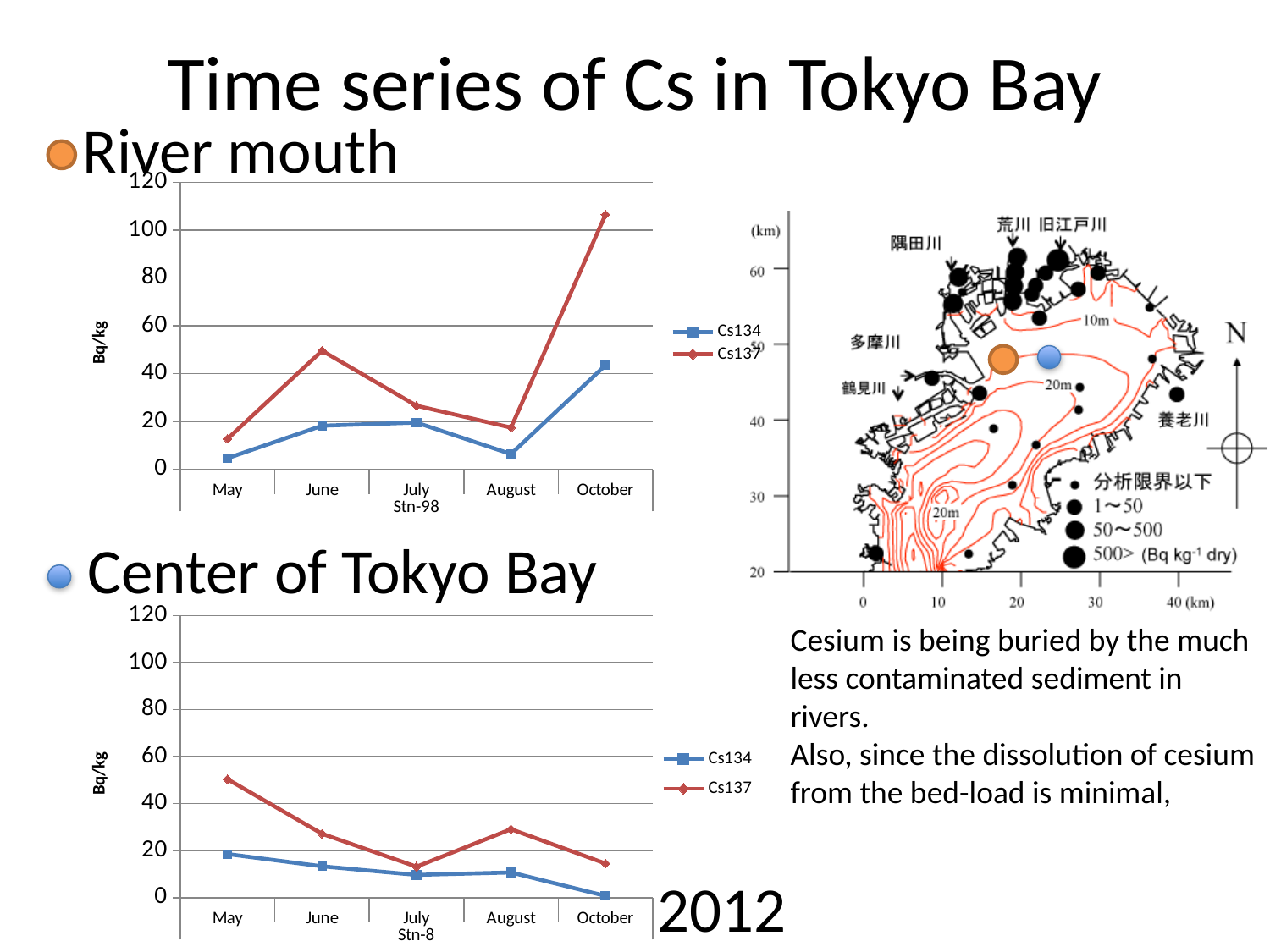
In the Center of Tokyo Bay chart, in which month is Cs134 lowest? October In the River mouth chart, in which month is Cs137 highest? October How many months are plotted along the x axis of the Center of Tokyo Bay chart? 5 In the River mouth chart, is the Cs137 value for June greater or less than 40? greater In the River mouth chart, in which month is Cs134 highest? October In the River mouth chart, is the Cs137 value for October greater or less than 100? greater What kind of chart is the River mouth chart? line chart How many series does the legend of the River mouth chart list? 2 What is the y-axis label of the Center of Tokyo Bay chart? Bq/kg In the Center of Tokyo Bay chart, does Cs134 generally rise or fall from May to October? fall In the River mouth chart, which series has the larger value in October, Cs134 or Cs137? Cs137 In the Center of Tokyo Bay chart, in which month is Cs137 highest? May